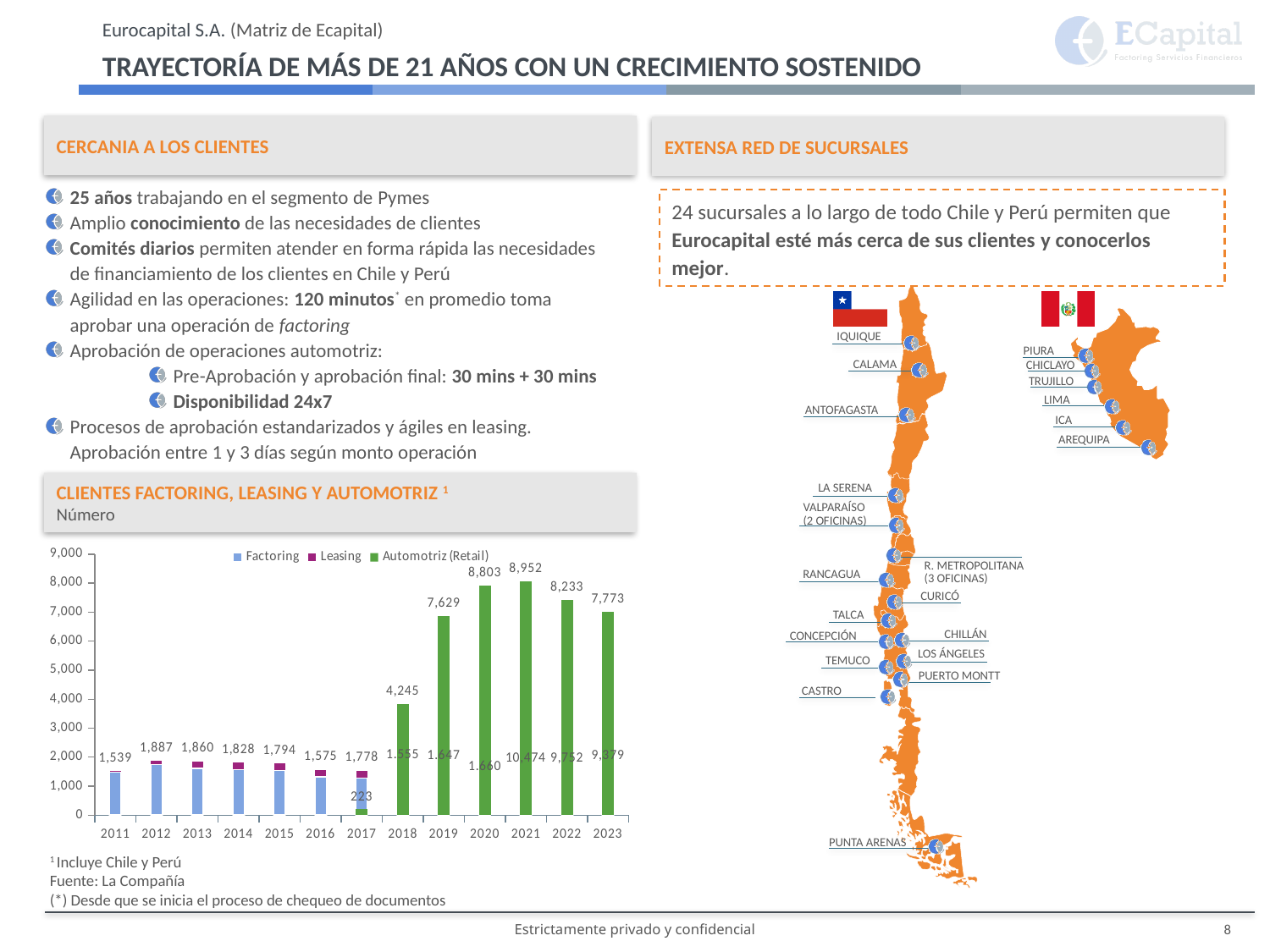
How many series does the legend of the 'CLIENTES FACTORING, LEASING Y AUTOMOTRIZ' chart list? 3 In the 'CLIENTES FACTORING, LEASING Y AUTOMOTRIZ' chart, do the labelled values rise or fall from 2012 to 2016? fall In the 'CLIENTES FACTORING, LEASING Y AUTOMOTRIZ' chart, which year has the larger labelled value, 2012 or 2016? 2012 Which colour represents Automotriz (Retail) in the legend of the 'CLIENTES FACTORING, LEASING Y AUTOMOTRIZ' chart? Green How many years are shown on the x axis of the 'CLIENTES FACTORING, LEASING Y AUTOMOTRIZ' chart? 13 In the 'CLIENTES FACTORING, LEASING Y AUTOMOTRIZ' chart, is the height of the green bar for 2019 greater or less than 6,000? greater What is the largest value labelled anywhere on the 'CLIENTES FACTORING, LEASING Y AUTOMOTRIZ' chart? 10,474 What kind of chart is shown under the heading 'CLIENTES FACTORING, LEASING Y AUTOMOTRIZ'? Bar chart What value is labelled on the green Automotriz (Retail) segment for 2017 in the 'CLIENTES FACTORING, LEASING Y AUTOMOTRIZ' chart? 223 What value is labelled for 2012 in the 'CLIENTES FACTORING, LEASING Y AUTOMOTRIZ' chart? 1,887 In the 'CLIENTES FACTORING, LEASING Y AUTOMOTRIZ' chart, what is the difference between the values labelled for 2012 and 2011? 348 What value is labelled for 2011 in the 'CLIENTES FACTORING, LEASING Y AUTOMOTRIZ' chart? 1,539